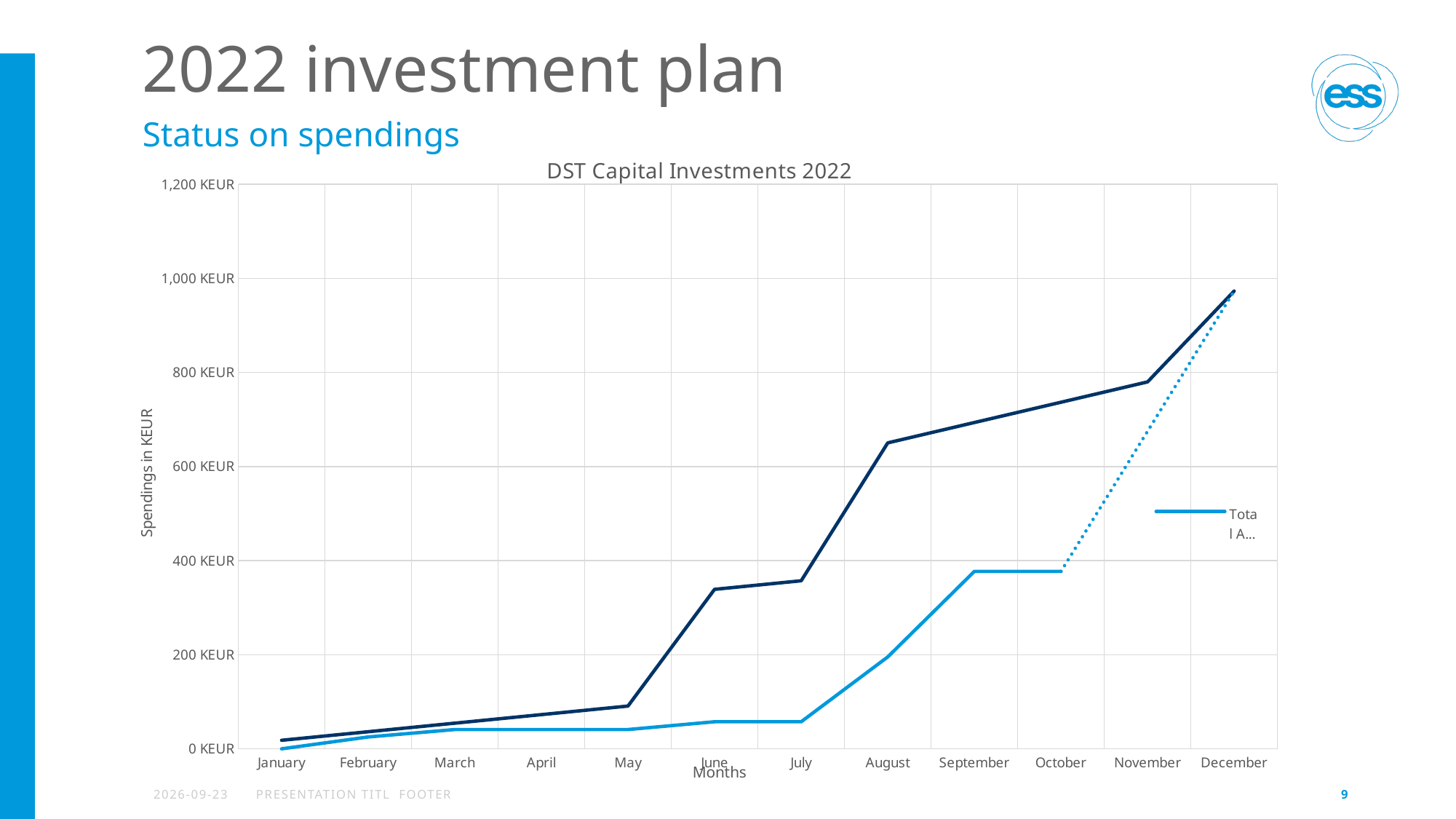
Is the value of the light blue line in September greater or less than 400 KEUR? less What is the label of the vertical axis of the chart? Spendings in KEUR In August, which line has the higher value, the dark blue line or the light blue line? the dark blue line In which month does the dark blue line reach its highest value? December Do the values of the dark blue line generally rise or fall from January to December? rise How many months are shown along the x axis of the chart? 12 Is the value of the dark blue line in May greater or less than 200 KEUR? less Is the value of the dark blue line in December greater or less than 800 KEUR? greater What kind of chart is shown on the slide? line chart What is the title of the chart? DST Capital Investments 2022